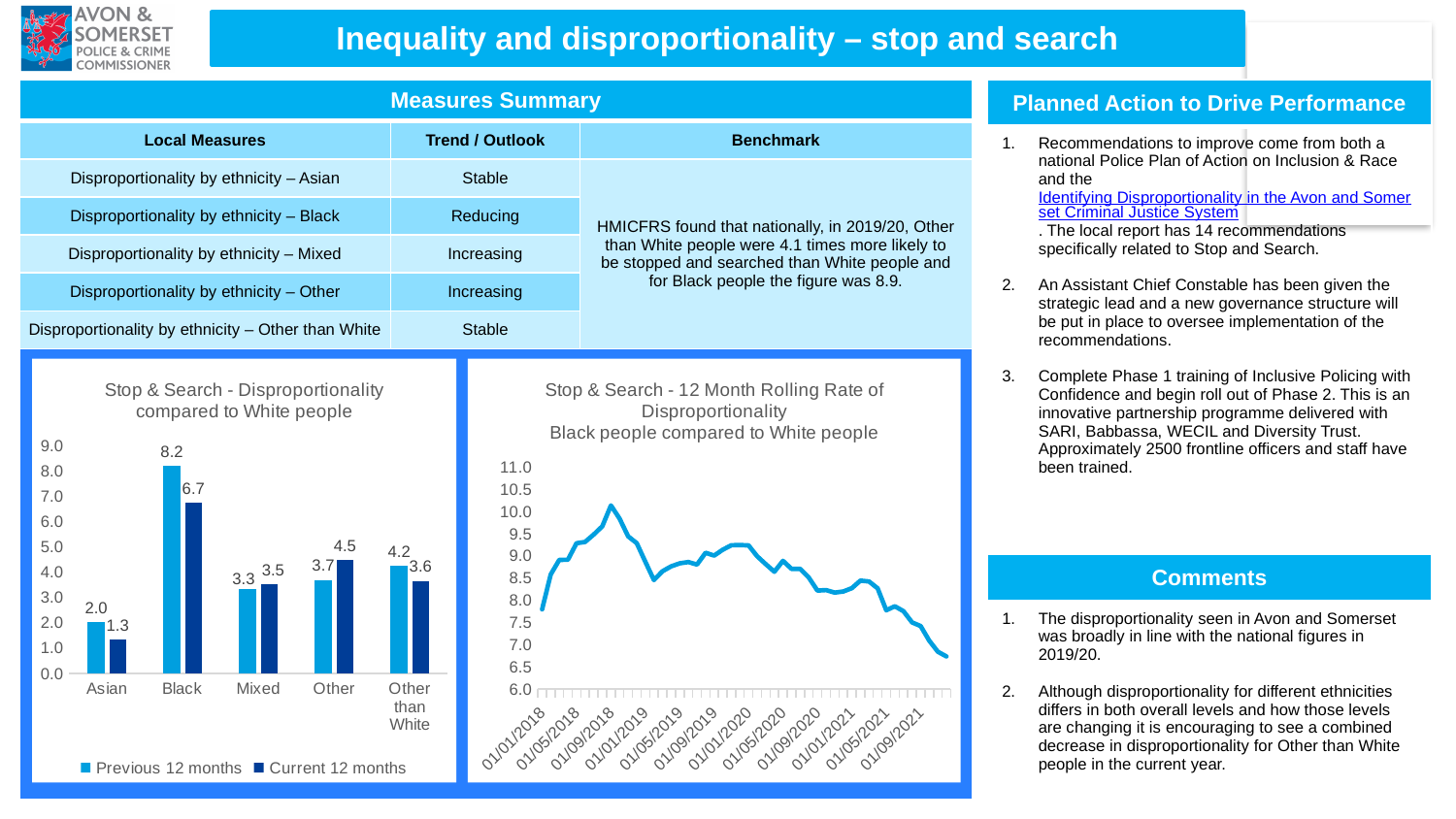
In the 'Stop & Search - Disproportionality compared to White people' chart, what is the difference between the Previous 12 months and Current 12 months values for Black? 1.5 In the 'Stop & Search - 12 Month Rolling Rate of Disproportionality' chart, do the values overall rise or fall from 2018 to 2021? fall In the 'Stop & Search - Disproportionality compared to White people' chart, what is the Previous 12 months value for Black? 8.2 What kind of chart is the 'Stop & Search - 12 Month Rolling Rate of Disproportionality' chart on the right? line chart How many categories are shown on the x axis of the 'Stop & Search - Disproportionality compared to White people' chart? 5 In the 'Stop & Search - Disproportionality compared to White people' chart, what is the Current 12 months value for Asian? 1.3 In the 'Stop & Search - Disproportionality compared to White people' chart, which category has the highest Current 12 months value? Black In the 'Stop & Search - Disproportionality compared to White people' chart, what is the Current 12 months value for Other? 4.5 In the 'Stop & Search - 12 Month Rolling Rate of Disproportionality' chart, does the value at 01/09/2021 lie above or below 8.0? below In the 'Stop & Search - Disproportionality compared to White people' chart, which category has the lowest Previous 12 months value? Asian In the 'Stop & Search - Disproportionality compared to White people' chart, is the Current 12 months value for Mixed larger or smaller than its Previous 12 months value? larger How many series does the legend of the 'Stop & Search - Disproportionality compared to White people' chart list? 2